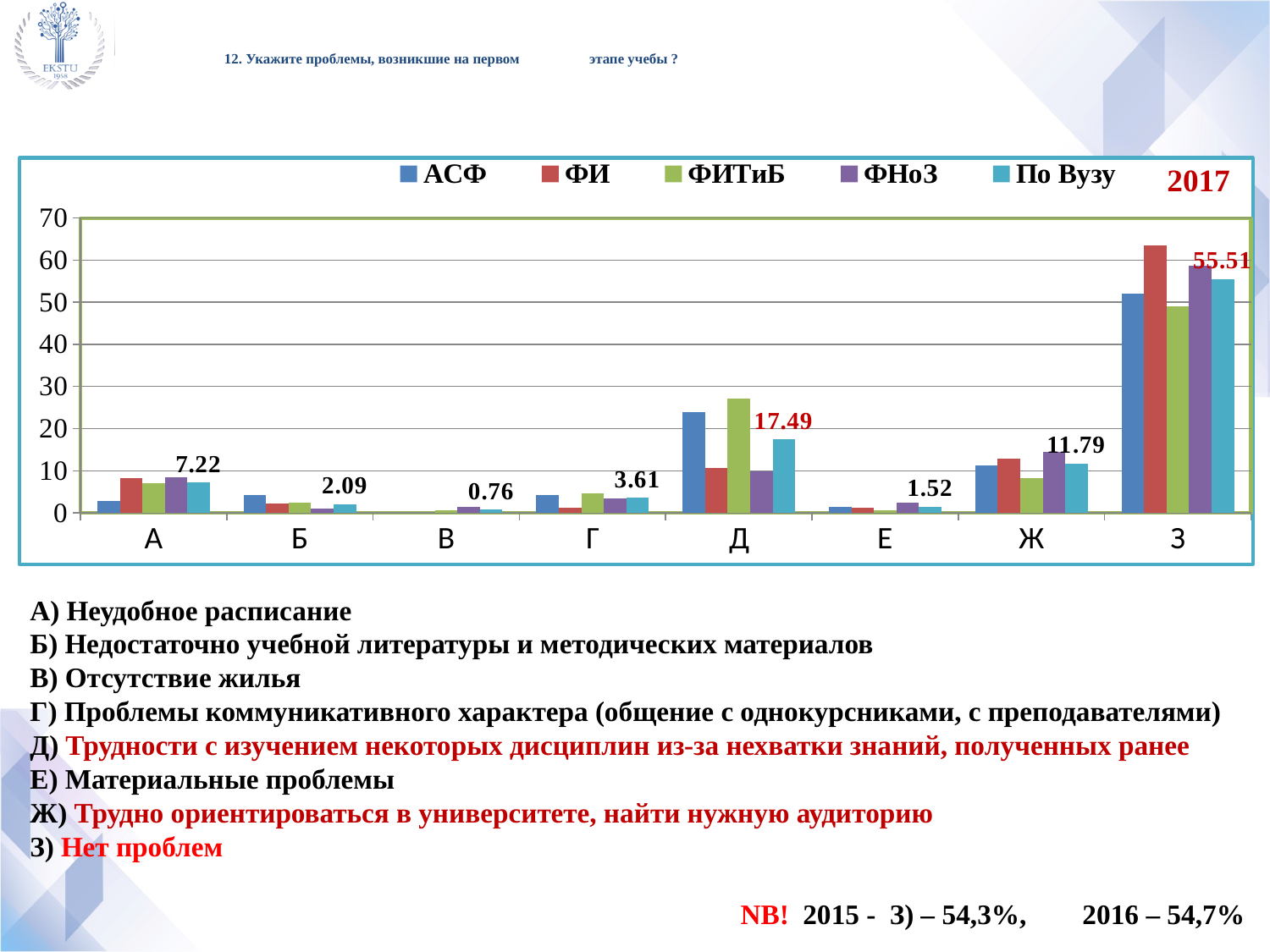
What is the value for По Вузу in category Ж? 11.79 Which is larger, the По Вузу value for Д or for Ж? Д Which category has the highest По Вузу value? З What is the value for По Вузу in category З? 55.51 Is the value for ФИ in category З greater or less than 60? greater What is the difference between the По Вузу values for З and Д? 38.02 What is the value for По Вузу in category В? 0.76 How many series does the legend list? 5 Which category has the lowest По Вузу value? В What is the value for По Вузу in category Д? 17.49 How many categories are shown on the x axis? 8 Is the value for ФИТиБ in category Д greater or less than 20? greater